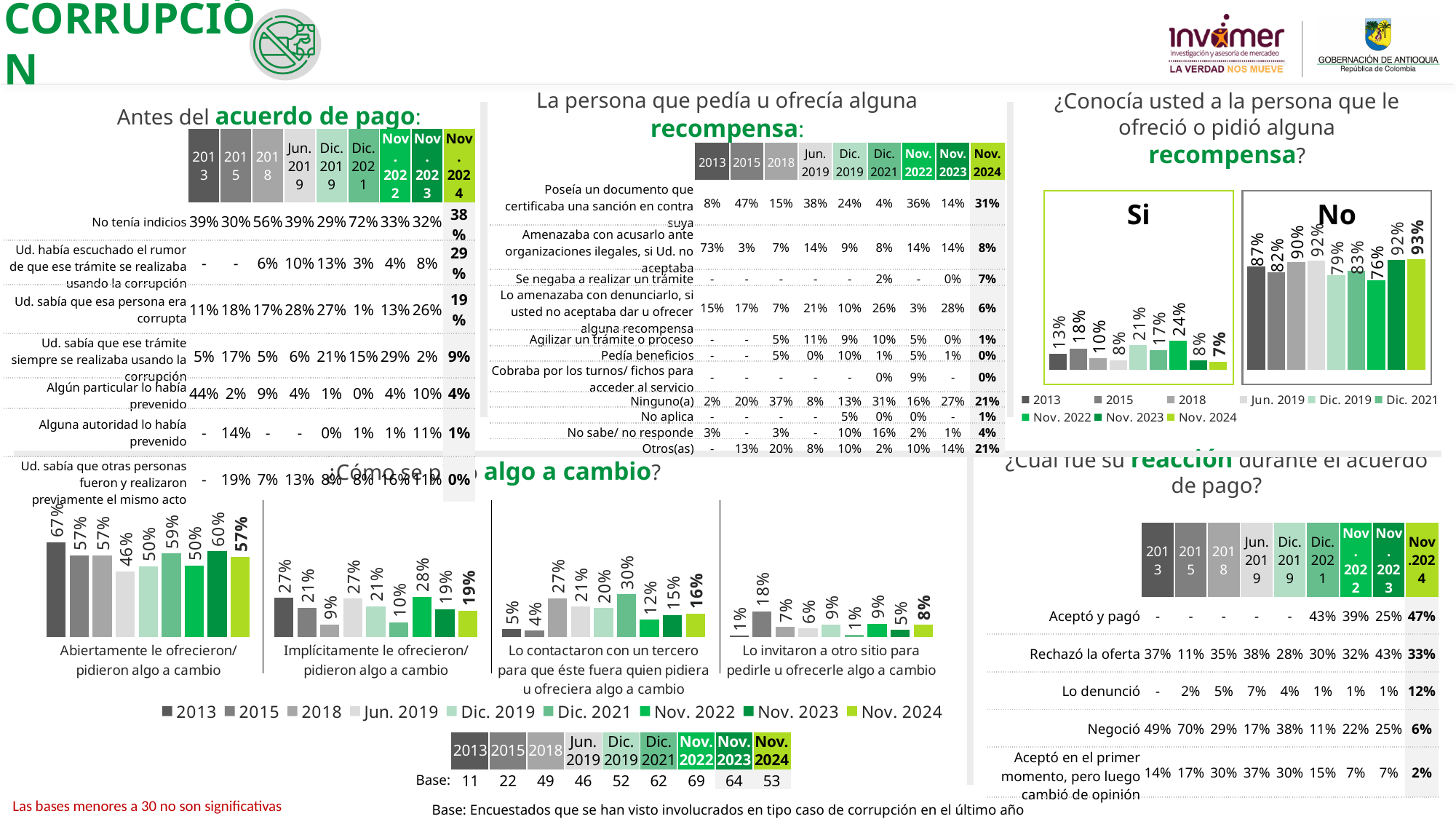
How many series does the legend of the chart '¿Conocía usted a la persona que le ofreció o pidió alguna recompensa?' list? 9 In the chart '¿Conocía usted a la persona que le ofreció o pidió alguna recompensa?', what is the 'No' value for Nov. 2024? 93% In the chart '¿Cómo se pidió algo a cambio?', what is the 2013 value for 'Abiertamente le ofrecieron/pidieron algo a cambio'? 67% In the chart '¿Cómo se pidió algo a cambio?', what is the Nov. 2024 value for 'Lo contactaron con un tercero para que éste fuera quien pidiera u ofreciera algo a cambio'? 16% In the chart '¿Cómo se pidió algo a cambio?', is the Nov. 2022 value for 'Implícitamente le ofrecieron/pidieron algo a cambio' larger or smaller than the Dic. 2021 value? larger In the chart '¿Conocía usted a la persona que le ofreció o pidió alguna recompensa?', which year has the highest 'Si' value? Nov. 2022 In the chart '¿Conocía usted a la persona que le ofreció o pidió alguna recompensa?', what is the difference between the 'No' value for 2013 and the 'No' value for Nov. 2022? 11% In the chart '¿Conocía usted a la persona que le ofreció o pidió alguna recompensa?', what is the 'Si' value for Nov. 2022? 24% In the chart '¿Cómo se pidió algo a cambio?', which year has the highest value for 'Lo invitaron a otro sitio para pedirle u ofrecerle algo a cambio'? 2015 How many categories are shown along the x axis of the chart '¿Cómo se pidió algo a cambio?'? 4 In the chart '¿Conocía usted a la persona que le ofreció o pidió alguna recompensa?', which year has the lowest 'Si' value? Nov. 2024 What type of chart is '¿Cómo se pidió algo a cambio?'? bar chart